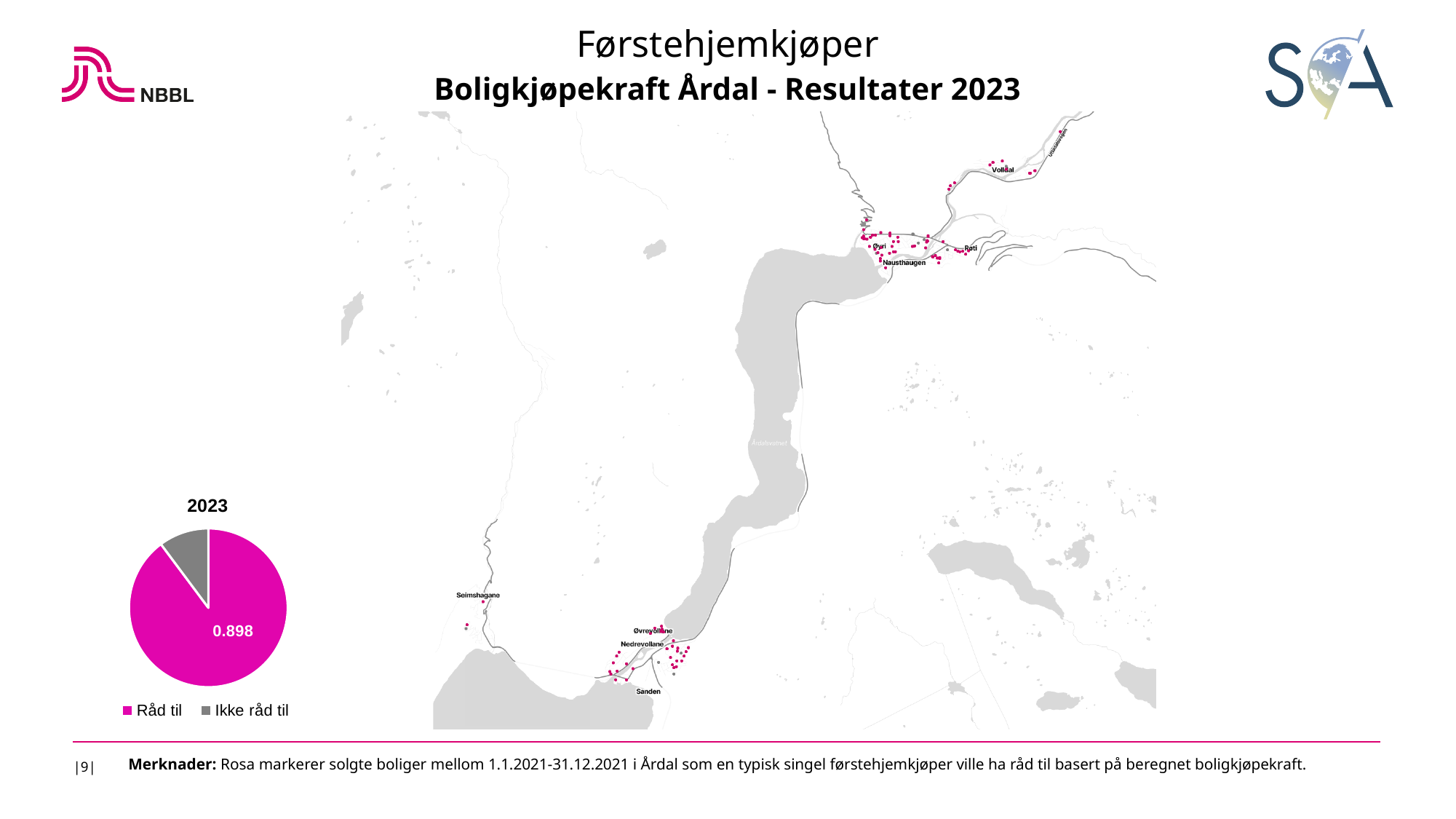
What kind of chart is shown at the bottom left of the slide? pie chart In the pie chart, what value is shown for "Råd til"? 0.898 Is the value for "Råd til" in the pie chart greater or less than 0.5? greater What is the title shown above the pie chart? 2023 Which slice of the pie chart is the smallest? Ikke råd til Which slice of the pie chart is the largest? Råd til What colour represents "Ikke råd til" in the pie chart? grey In the pie chart, which is larger: "Råd til" or "Ikke råd til"? Råd til How many categories does the pie chart's legend list? 2